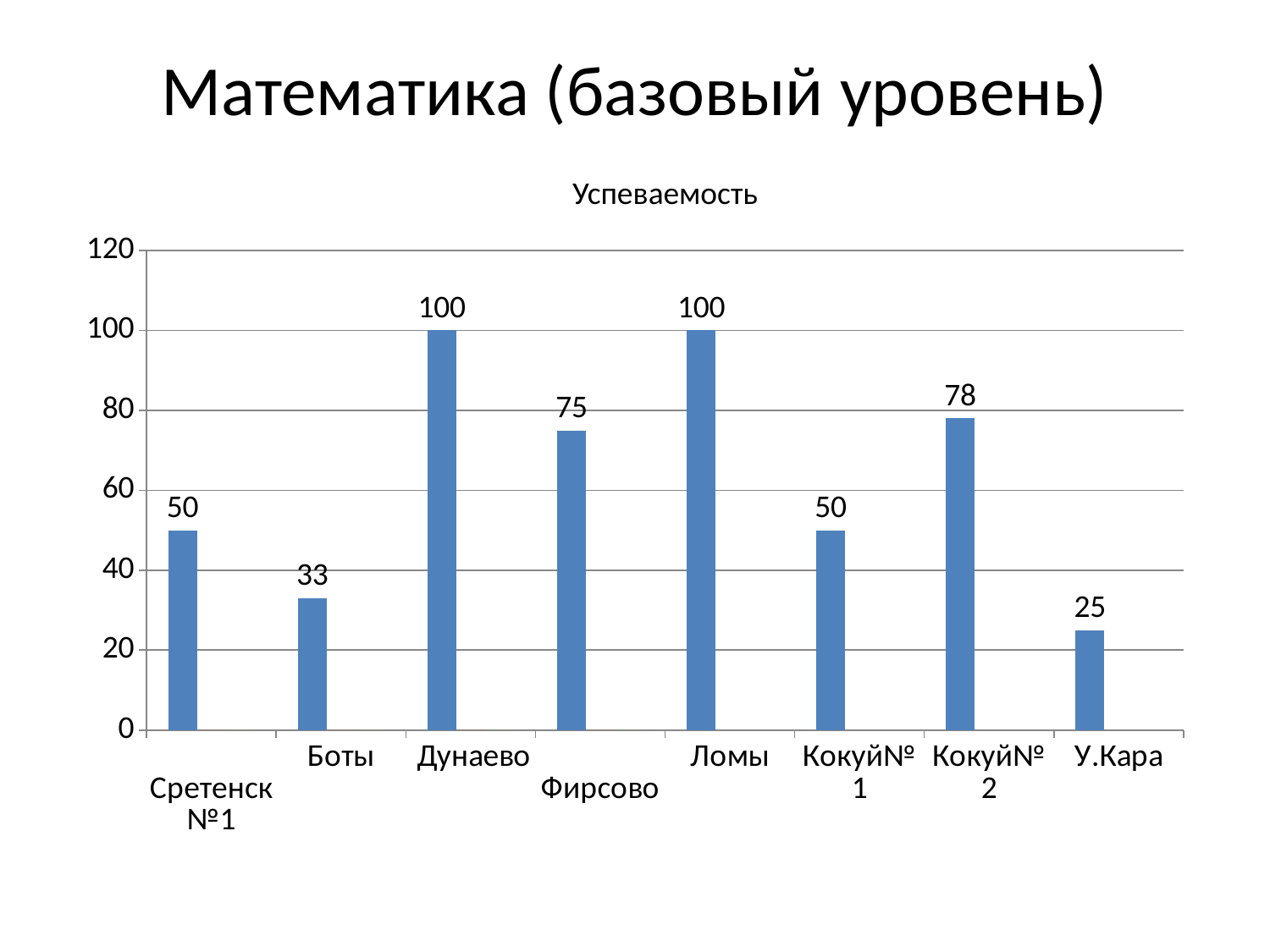
Which categories share the highest value of 100? Дунаево and Ломы Which category has the lowest value? У.Кара Which is larger, the value for Фирсово or the value for Кокуй№2? Кокуй№2 What is the difference between the values for Сретенск №1 and Боты? 17 What is the value for Кокуй№2? 78 What is the value for У.Кара? 25 What is the difference between the values for Кокуй№2 and Кокуй№1? 28 What is the value for Фирсово? 75 What is the title of the chart? Успеваемость What is the value for Боты? 33 What kind of chart is shown on the slide? Bar chart How many categories are shown on the x axis? 8